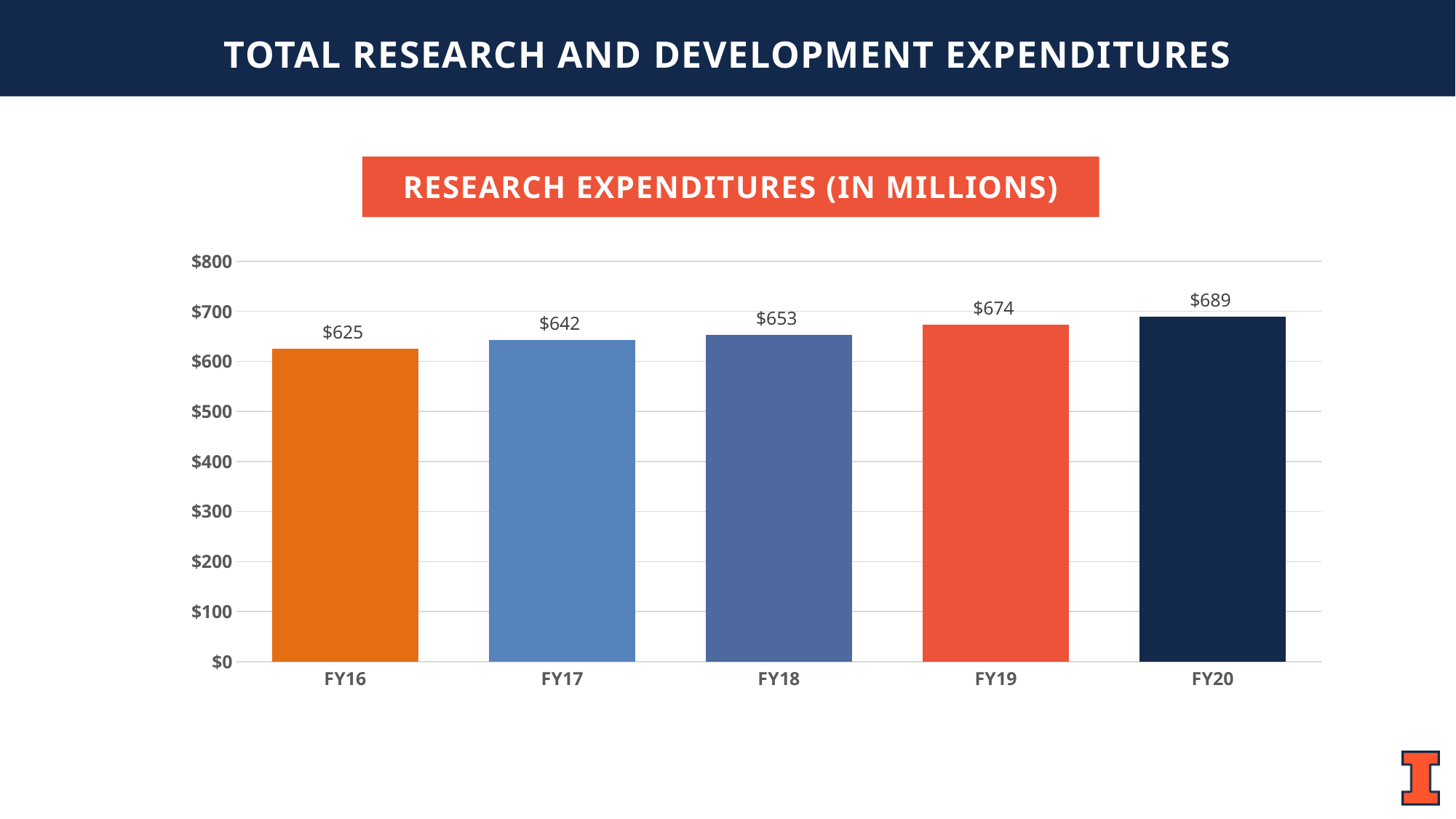
Is the value for FY20 greater or less than $600? greater What is the research expenditure value for FY16? $625 Which fiscal year has the highest research expenditure? FY20 Do the research expenditure values rise or fall from FY16 to FY20? Rise What kind of chart is shown on the slide? Bar chart What is the title shown above the chart? Research Expenditures (in Millions) Which is larger, the research expenditure for FY17 or for FY19? FY19 What is the difference between the FY20 and FY16 research expenditure values? $64 How many fiscal years are shown on the chart? 5 What is the difference between the FY19 and FY18 research expenditure values? $21 What is the research expenditure value for FY18? $653 Which fiscal year has the lowest research expenditure? FY16